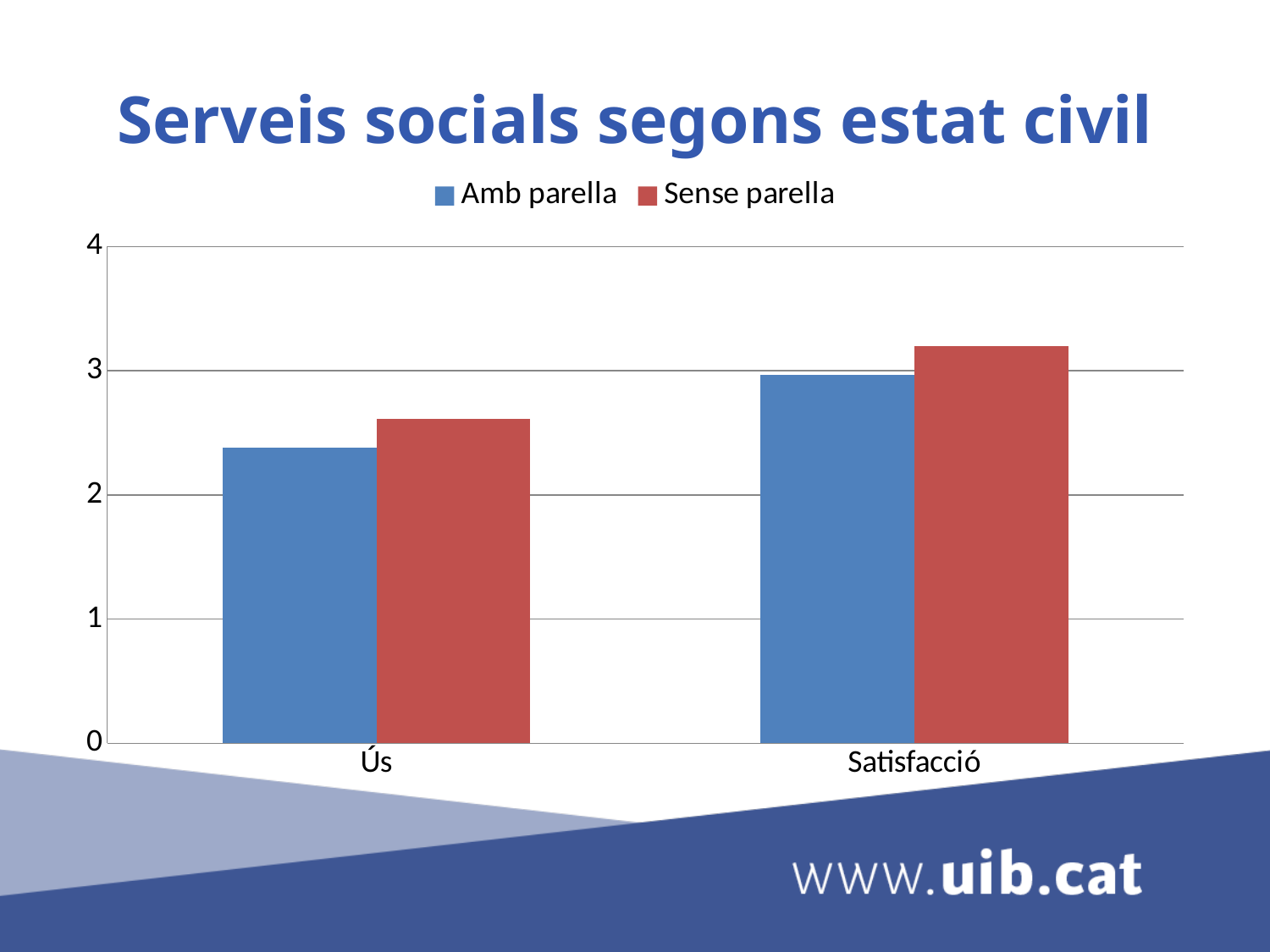
Is the value for Sense parella in the Ús category greater or less than 3? less In the Ús category, which series has the larger value, Amb parella or Sense parella? Sense parella Which series is shown in red? Sense parella What is the title of the chart? Serveis socials segons estat civil How many categories are shown on the x axis? 2 Which bar is the tallest in the chart? Sense parella in Satisfacció Is the value for Sense parella in the Satisfacció category greater or less than 3? greater How many series does the legend list? 2 What kind of chart is shown on the slide? Bar chart In the Satisfacció category, which series has the larger value, Amb parella or Sense parella? Sense parella Is the value for Amb parella in the Ús category greater or less than 2? greater Which bar is the shortest in the chart? Amb parella in Ús